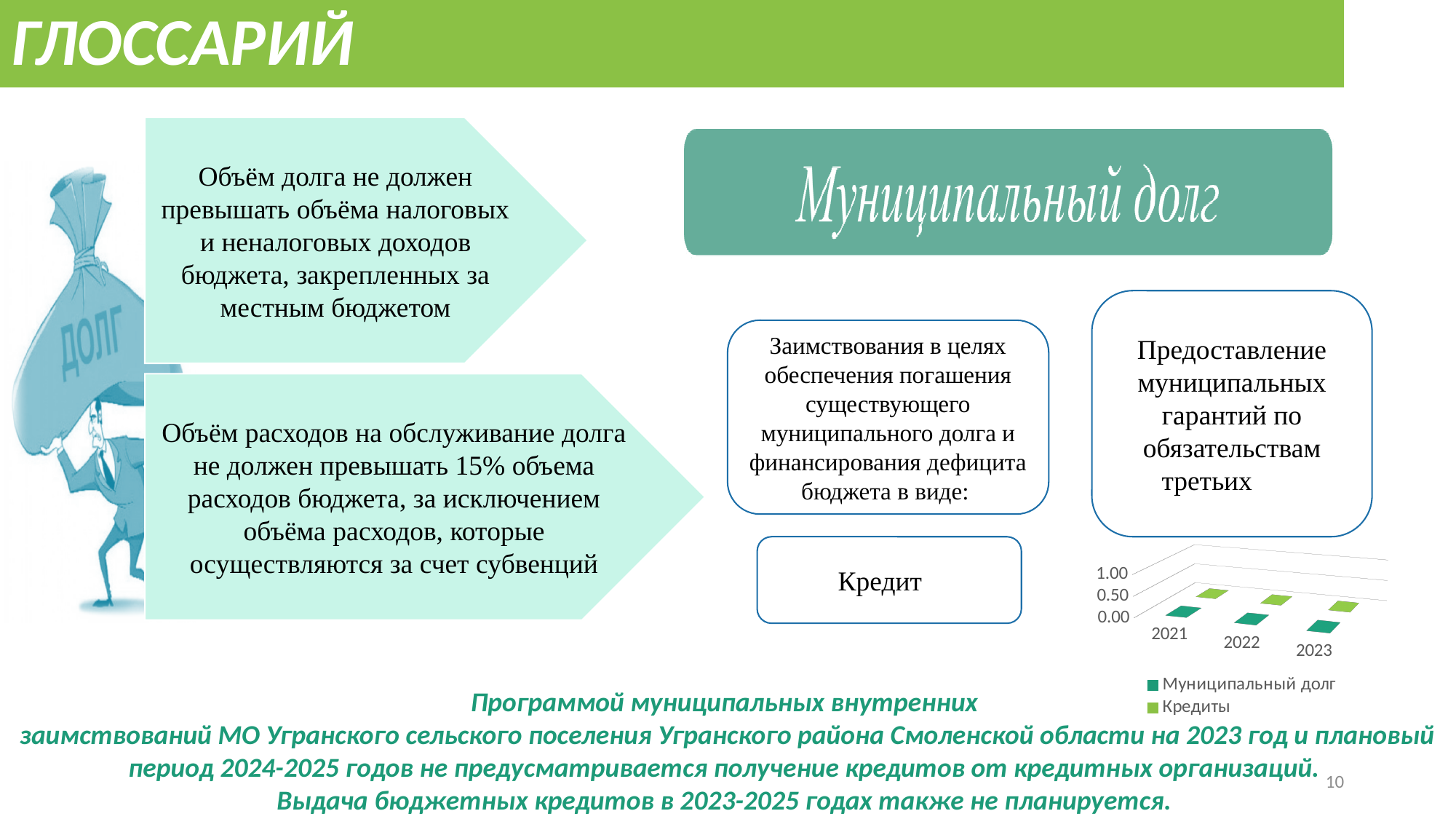
Is the value for Кредиты in 2022 greater or less than 1.00? less What is the highest tick value shown on the chart's vertical axis? 1.00 Is the value for Муниципальный долг in 2022 greater or less than 1.00? less How many series does the chart's legend list? 2 Is the value for Муниципальный долг in 2021 greater or less than 0.50? less What kind of chart is shown on the slide? bar chart Which years are shown as categories on the chart's x axis? 2021, 2022, 2023 What are the two series named in the chart's legend? Муниципальный долг, Кредиты How many categories are shown on the x axis of the chart? 3